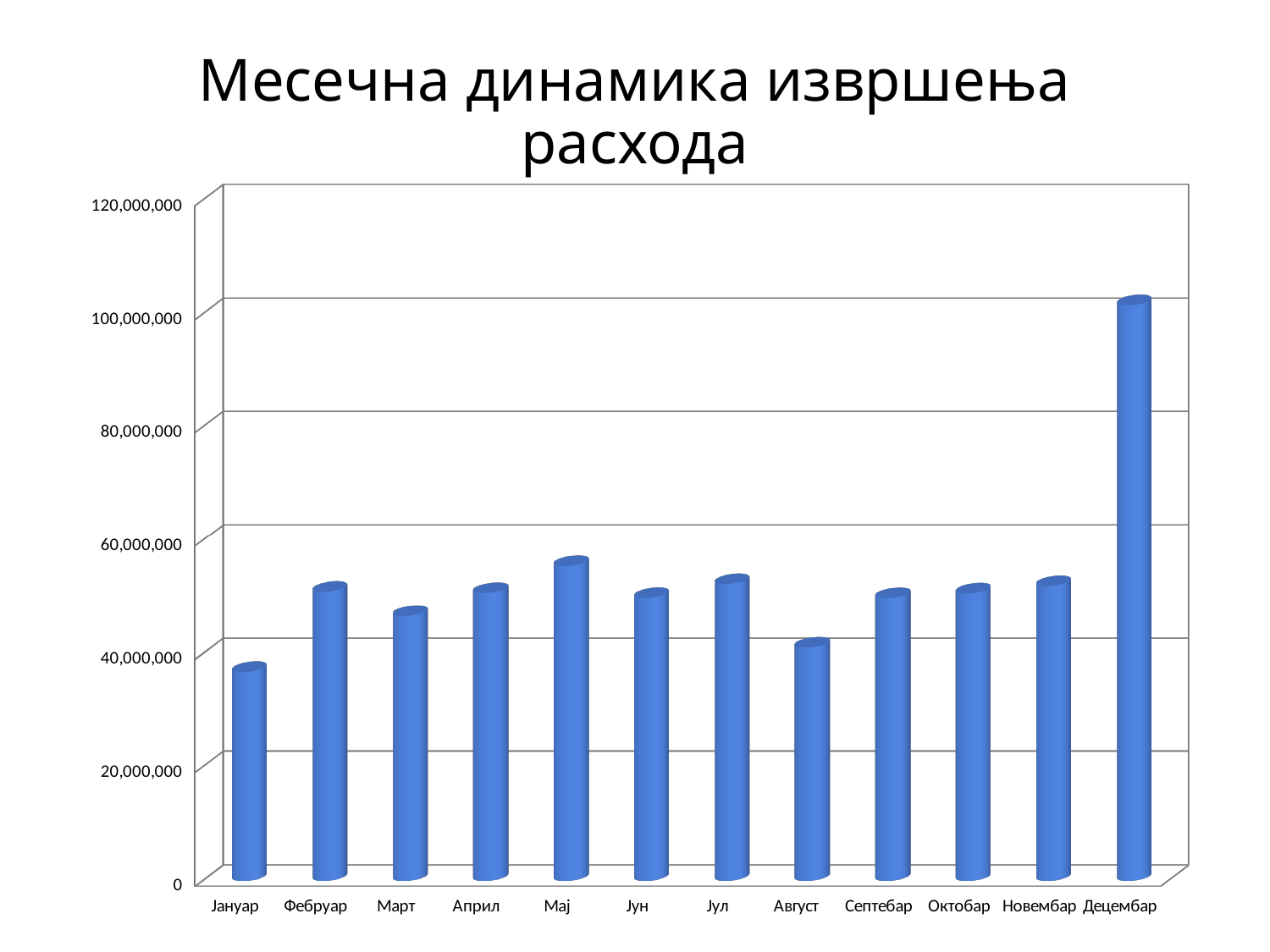
What is the title of the chart? Месечна динамика извршења расхода Which is larger, the value for Јануар or the value for Фебруар? Фебруар Which is larger, the value for Август or the value for Мај? Мај Which is larger, the value for Децембар or the value for Мај? Децембар Is the value for Март greater or less than 60,000,000? less Which month has the highest value? Децембар What type of chart is shown on the slide? Bar chart Is the value for Децембар greater or less than 80,000,000? greater How many months (categories) are shown on the x axis? 12 Is the value for Мај greater or less than 40,000,000? greater Which month has the lowest value? Јануар